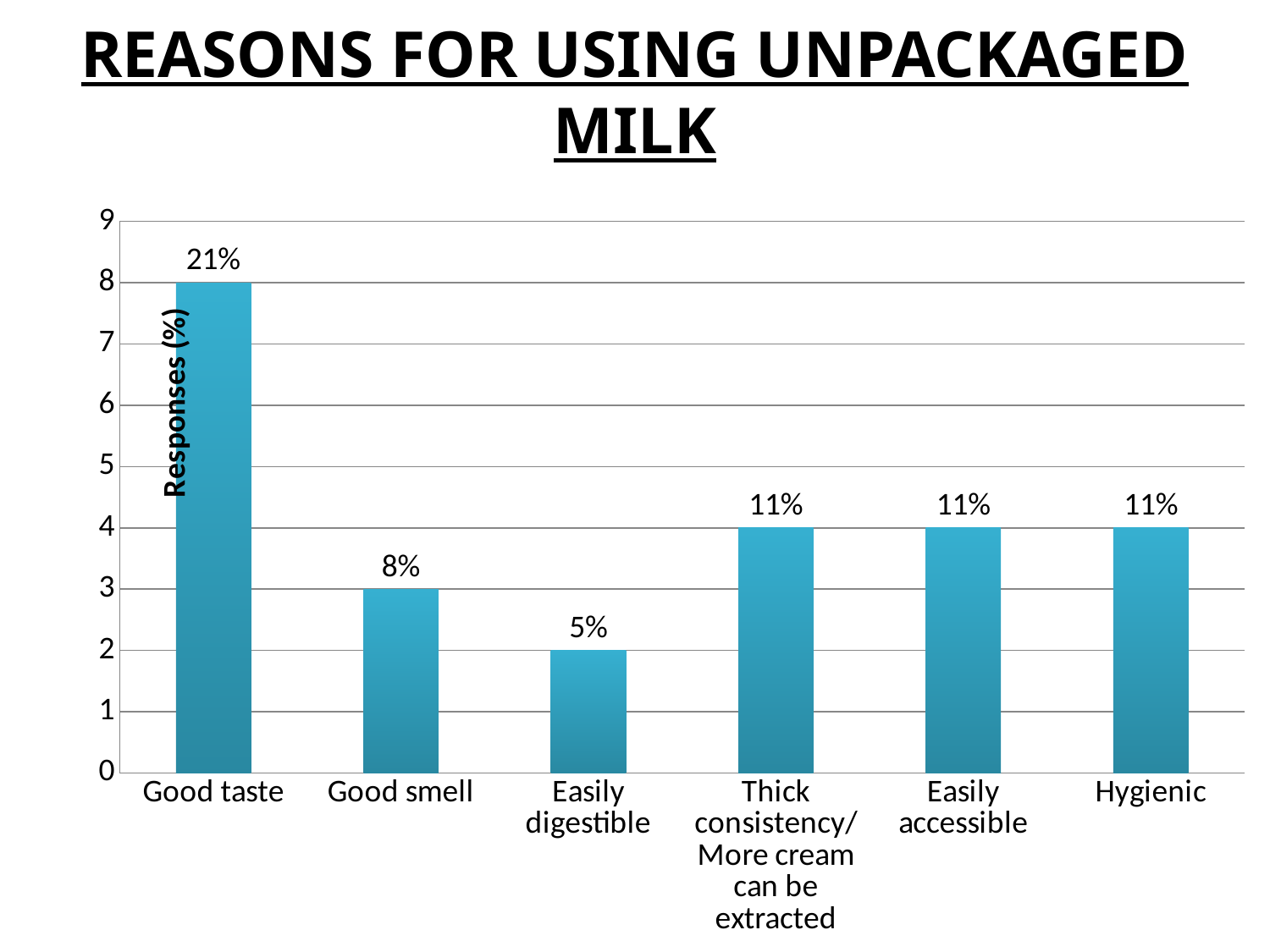
Which reason has the lowest bar? Easily digestible What data label is shown above the bar for Good smell? 8% What data label is shown above the bar for Easily digestible? 5% How many reasons are shown on the x axis? 6 What data label is shown above the bar for Good taste? 21% What is the title of the y axis? Responses (%) What kind of chart is shown on the slide? bar chart What is the difference between the data labels for Good taste and Good smell? 13% Which bar is taller: Good smell or Easily digestible? Good smell Which reason has the highest bar? Good taste Is the bar for Good taste greater or less than 5 on the y axis? greater What value on the y axis does the bar for Hygienic reach? 4